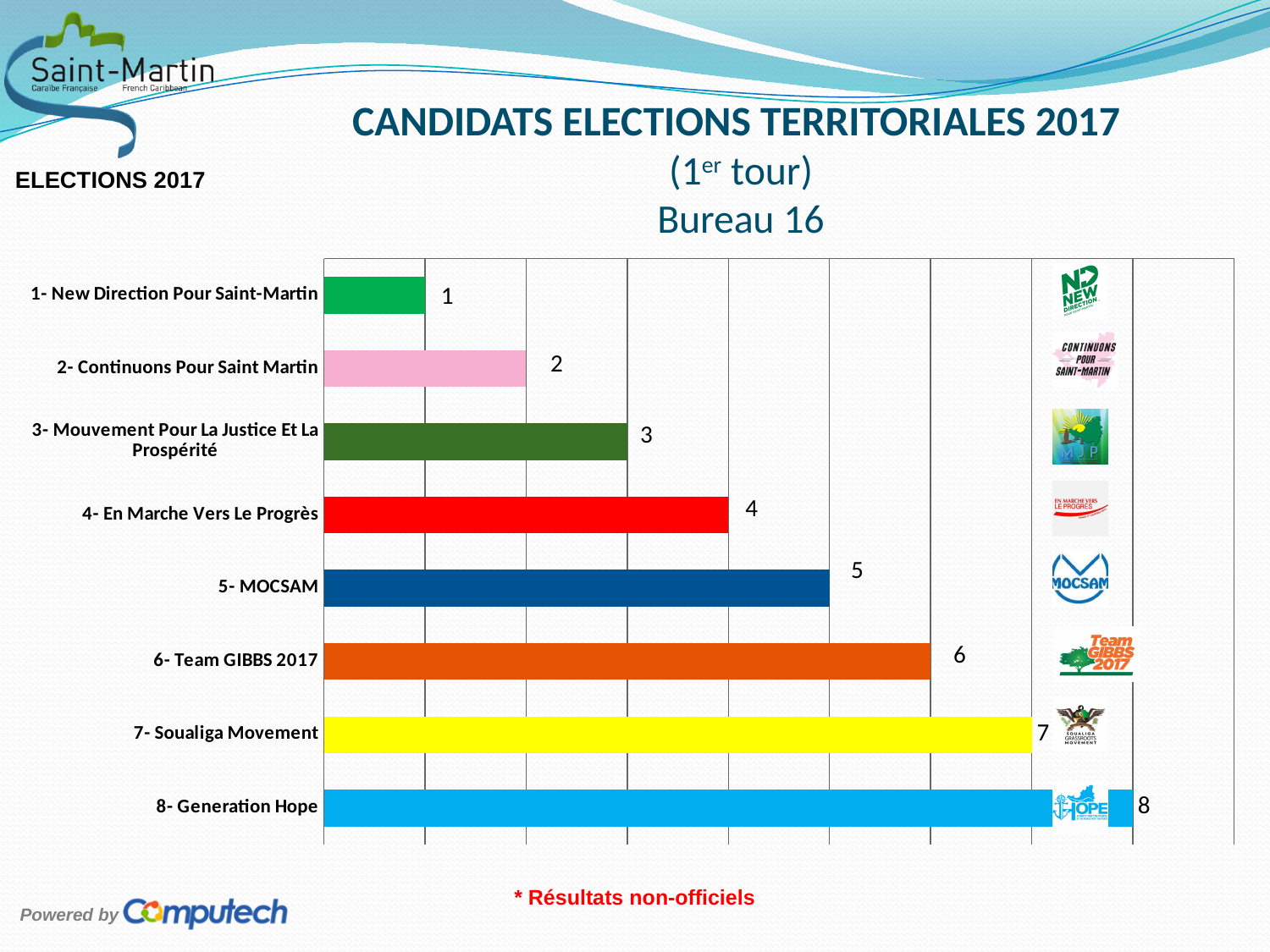
What colour is the bar for 4- En Marche Vers Le Progrès? Red Which category has the lowest value? 1- New Direction Pour Saint-Martin Which has a larger value, 4- En Marche Vers Le Progrès or 2- Continuons Pour Saint Martin? 4- En Marche Vers Le Progrès Which category has the highest value? 8- Generation Hope What value is shown for 7- Soualiga Movement? 7 What is the difference between the values for 6- Team GIBBS 2017 and 3- Mouvement Pour La Justice Et La Prospérité? 3 What value is shown for 5- MOCSAM? 5 What kind of chart is shown on the slide? Bar chart How many categories are shown in the chart? 8 What is the title of the chart? CANDIDATS ELECTIONS TERRITORIALES 2017 (1er tour) Bureau 16 What value is shown for 2- Continuons Pour Saint Martin? 2 Do the values increase or decrease going down the list of categories from top to bottom? Increase